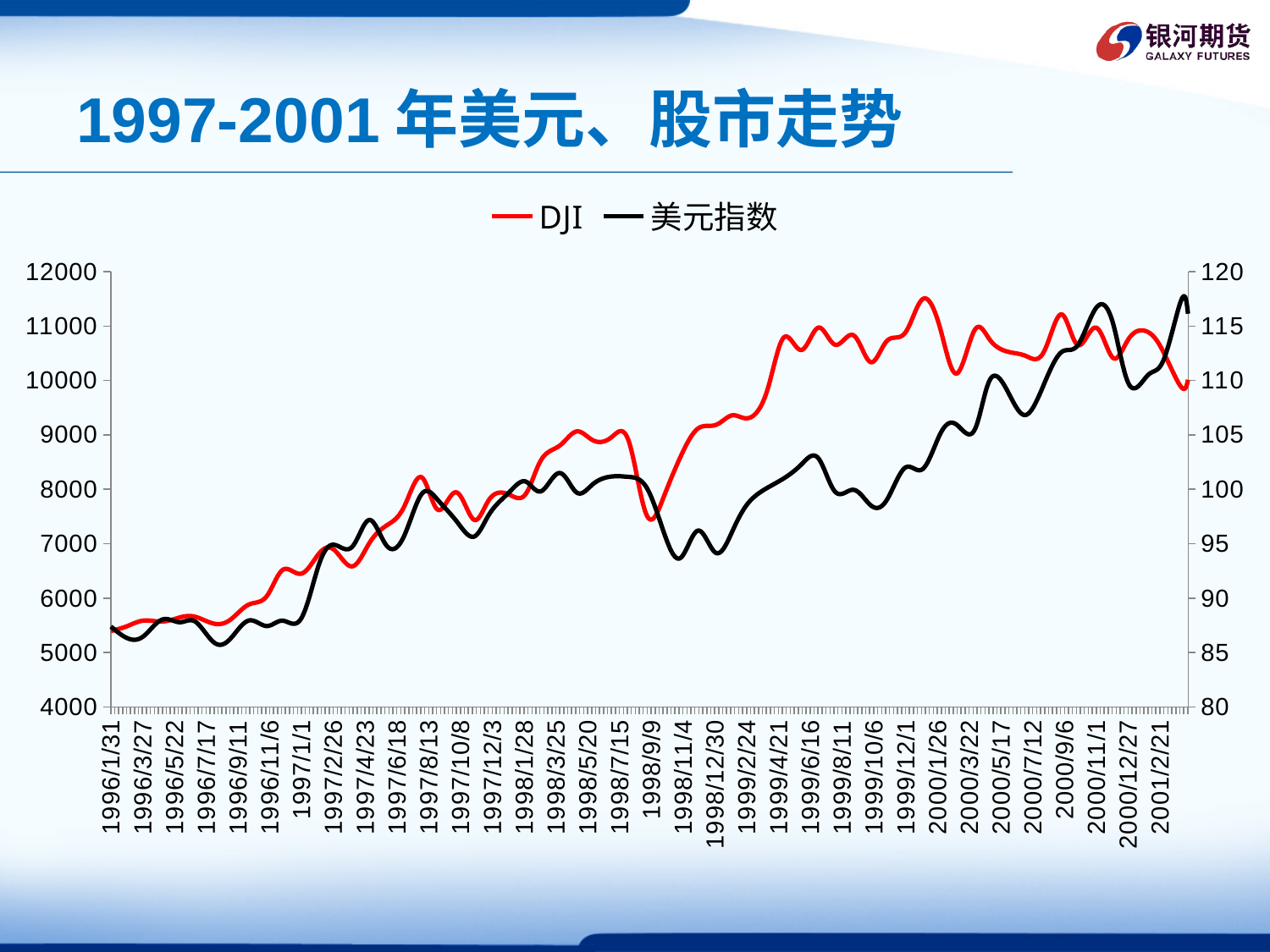
How many series does the legend list? 2 Is the DJI value at 1998/9/9 greater or less than 8000? less Overall, does the 美元指数 line rise or fall across the period shown? rise Is the 美元指数 value at 1996/7/17 greater or less than 90? less Which series is drawn in red? DJI Overall, does the DJI line rise or fall from 1996/1/31 to 2001/2/21? rise Is the 美元指数 value at the end of the series (after 2001/2/21) greater or less than 115? greater What kind of chart is shown on the slide? line chart What is the title of the chart on the slide? 1997-2001 年美元、股市走势